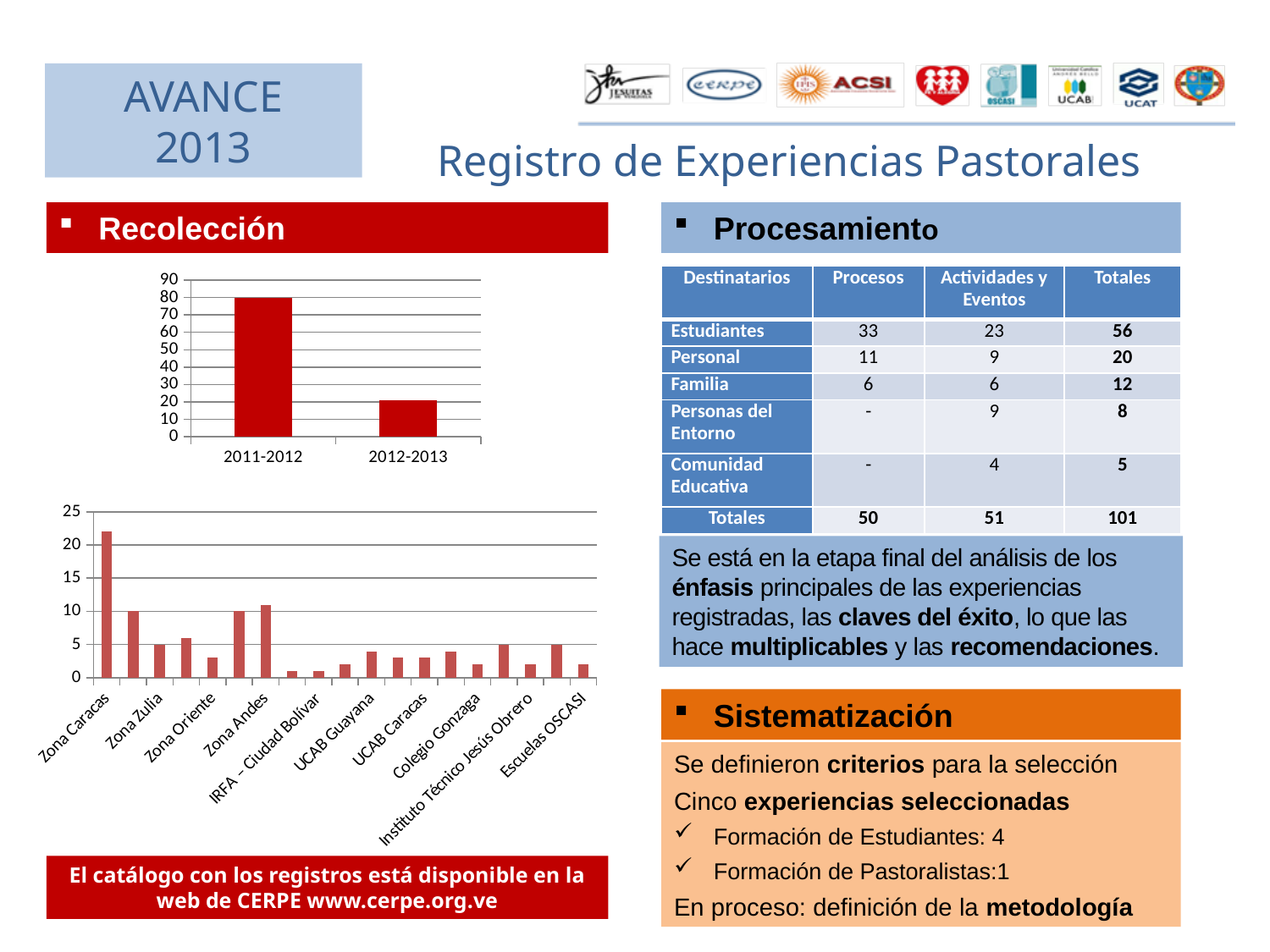
In the top chart on the left, do the values rise or fall from 2011-2012 to 2012-2013? fall In the bottom chart on the left, is the value for Escuelas OSCASI greater or less than 5? less What type of chart is the bottom chart on the left of the slide? bar chart In the bottom chart on the left, what is the highest value shown on the y axis? 25 In the top chart on the left, what colour are the bars? red What type of chart is the top chart on the left of the slide? bar chart In the top chart on the left, which category has the higher bar, 2011-2012 or 2012-2013? 2011-2012 In the bottom chart on the left, which category has the highest bar? Zona Caracas In the bottom chart on the left, is the value for Zona Caracas greater or less than 20? greater In the top chart on the left, is the value for 2011-2012 greater or less than 70? greater In the top chart on the left, how many categories are shown on the x axis? 2